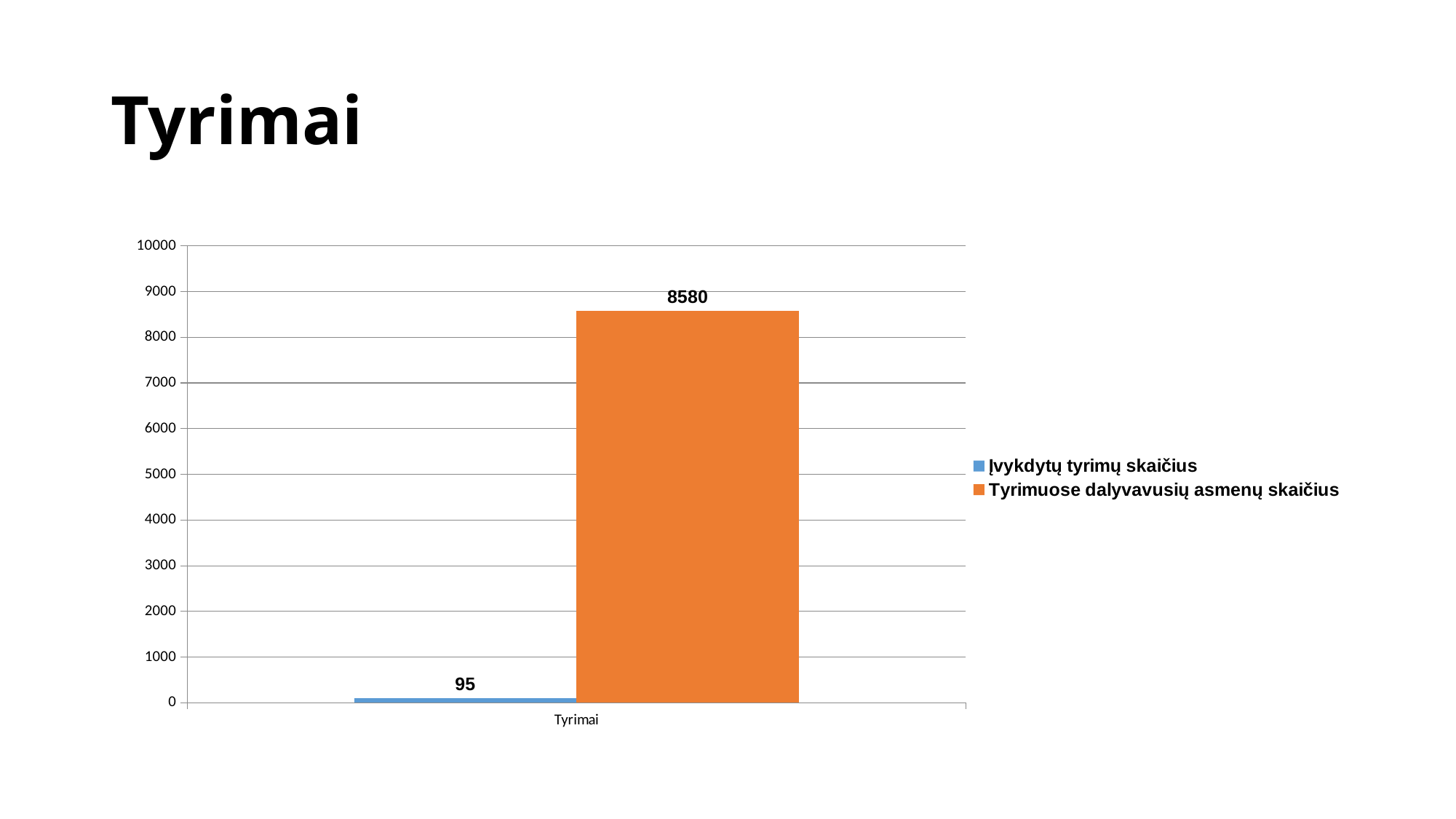
What kind of chart is shown? bar chart Is the value for Įvykdytų tyrimų skaičius greater or less than 1000? less Which series has the higher value? Tyrimuose dalyvavusių asmenų skaičius What colour is the bar for Tyrimuose dalyvavusių asmenų skaičius? orange What is the difference between Tyrimuose dalyvavusių asmenų skaičius and Įvykdytų tyrimų skaičius? 8485 Which series has the lower value? Įvykdytų tyrimų skaičius Is the value for Tyrimuose dalyvavusių asmenų skaičius greater or less than 8000? greater What is the value for Įvykdytų tyrimų skaičius? 95 What is the label of the category on the x axis? Tyrimai What is the value for Tyrimuose dalyvavusių asmenų skaičius? 8580 How many categories are shown on the x axis? 1 How many series does the legend list? 2